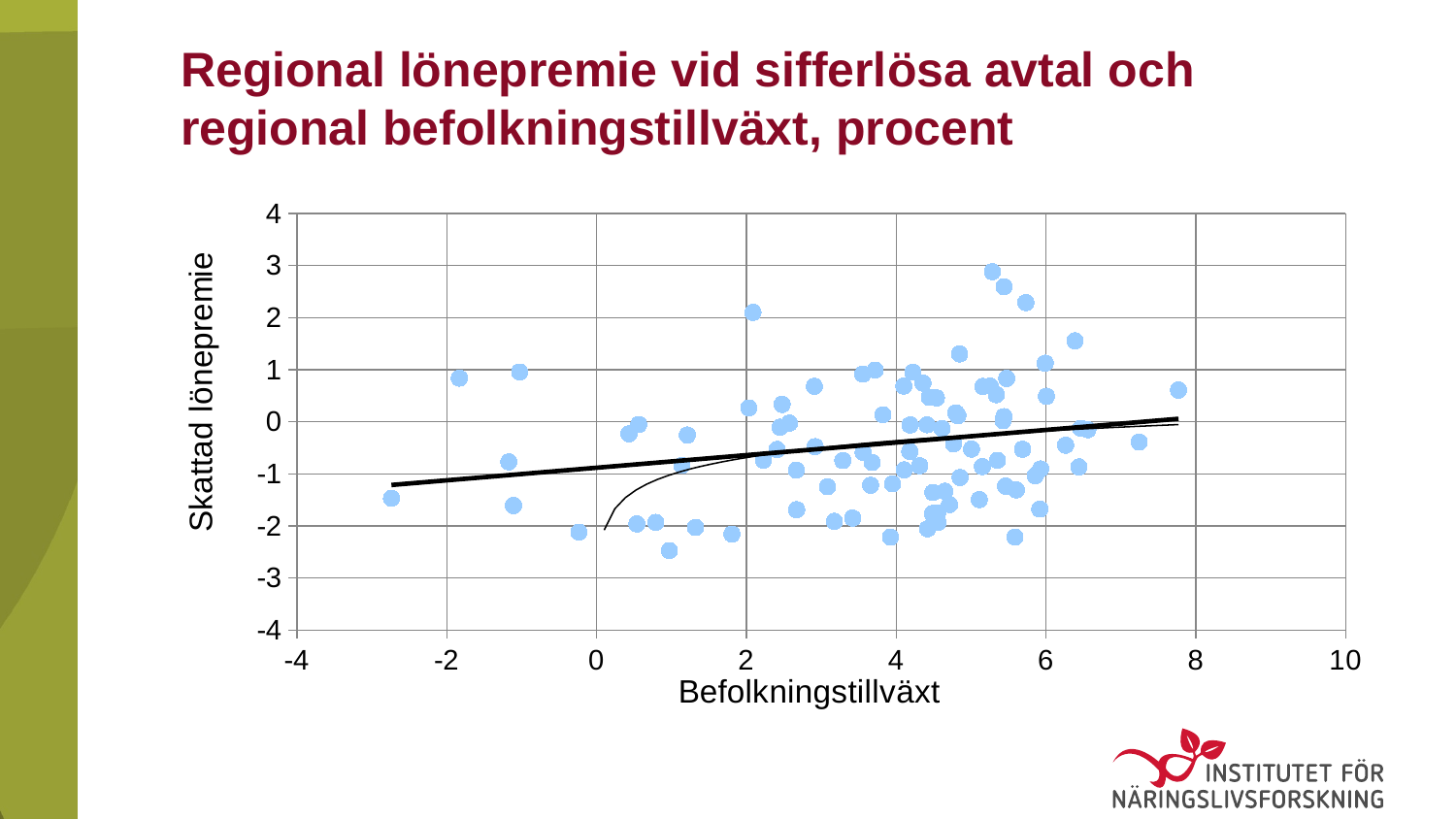
What is the maximum value shown on the x axis? 10 Does the thick trend line rise or fall as Befolkningstillväxt increases? rises What is the label of the x axis? Befolkningstillväxt What is the label of the y axis? Skattad lönepremie Is the Befolkningstillväxt value of the leftmost point greater or less than -2? less Is the highest plotted Skattad lönepremie value greater or less than 2? greater What kind of chart is shown on the slide? scatter plot Is the Befolkningstillväxt value of the rightmost point greater or less than 6? greater What is the minimum value shown on the y axis? -4